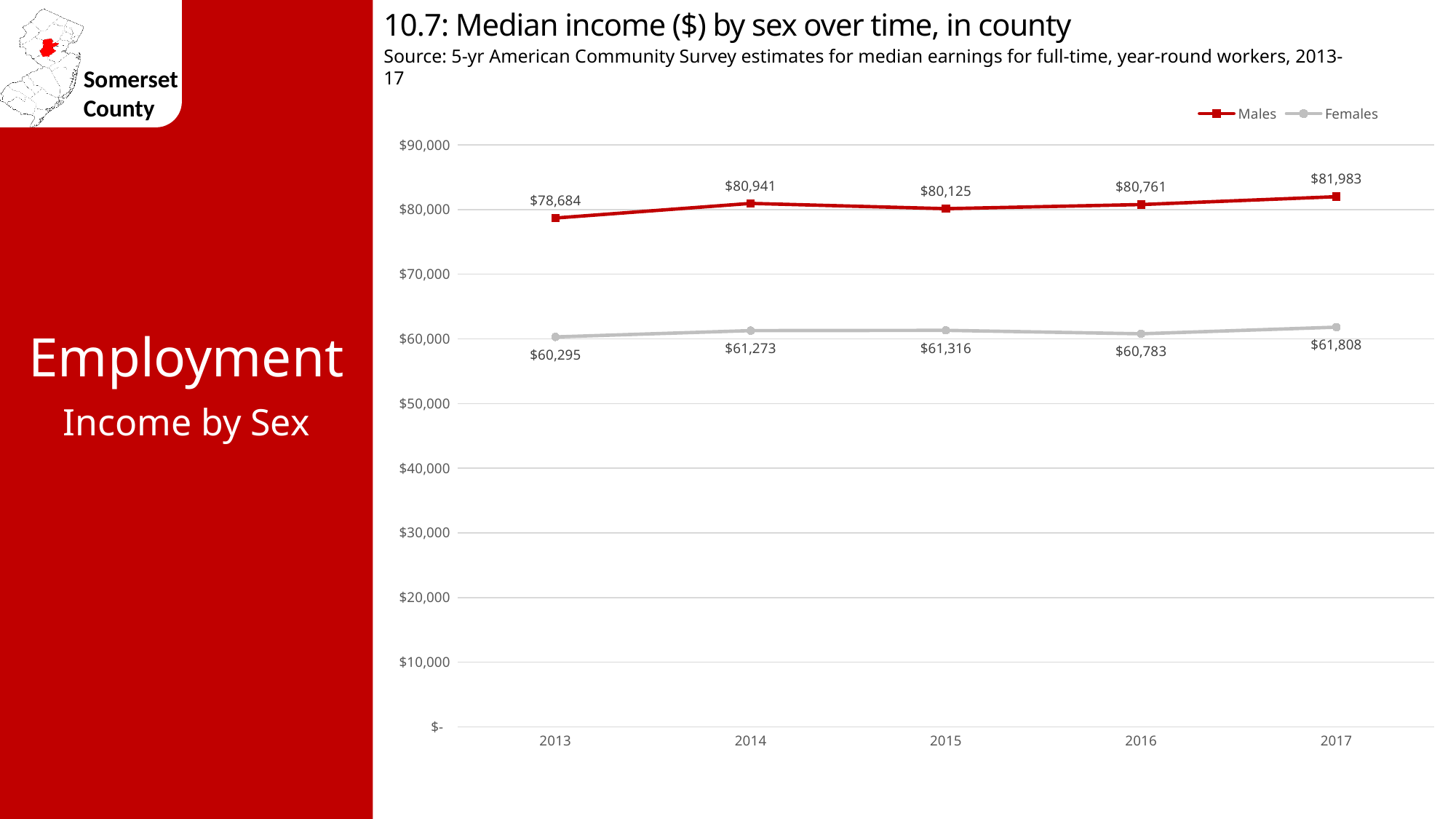
Is the median income for Females in 2016 greater or less than $70,000? less How many series does the legend list? 2 What is the median income for Males in 2013? $78,684 What colour is the Males line? red What kind of chart is shown on the slide? line chart What is the median income for Females in 2017? $61,808 What is the difference between the Males and Females median income in 2017? $20,175 What is the median income for Females in 2015? $61,316 In which year is the median income for Females lowest? 2013 Which is larger, the Males median income in 2014 or in 2015? 2014 In which year is the median income for Males highest? 2017 How many years are shown on the x axis? 5